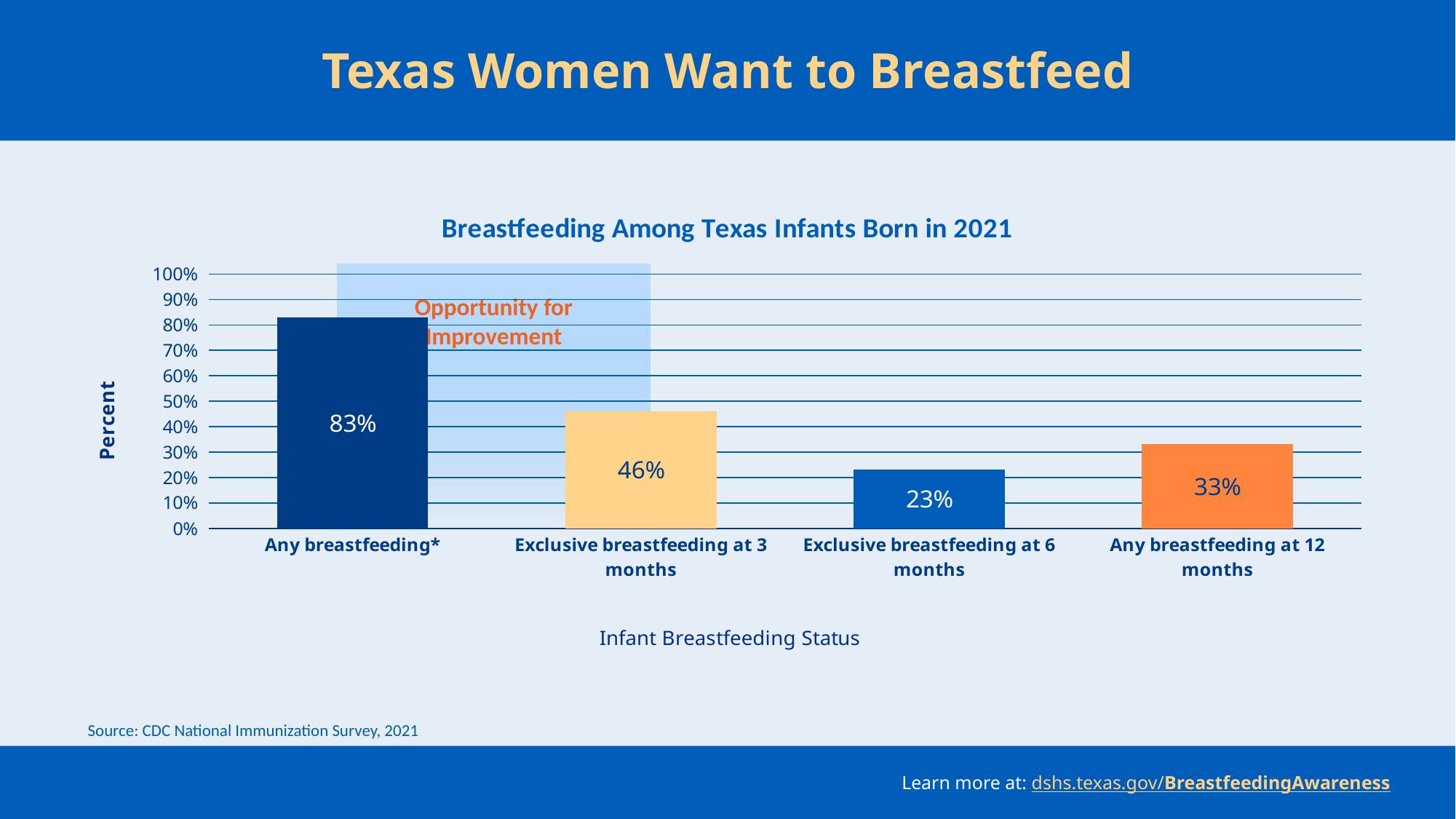
Which category has the highest value? Any breastfeeding* What is the value for Any breastfeeding at 12 months? 33% How many categories are shown on the x axis? 4 What kind of chart is shown on the slide? Bar chart What is the title of the chart? Breastfeeding Among Texas Infants Born in 2021 Which is larger, Exclusive breastfeeding at 3 months or Any breastfeeding at 12 months? Exclusive breastfeeding at 3 months Which category has the lowest value? Exclusive breastfeeding at 6 months What is the difference between Any breastfeeding at 12 months and Exclusive breastfeeding at 6 months? 10% What is the value for Any breastfeeding*? 83% What is the value for Exclusive breastfeeding at 3 months? 46% What is the value for Exclusive breastfeeding at 6 months? 23% What is the difference between Any breastfeeding* and Exclusive breastfeeding at 3 months? 37%